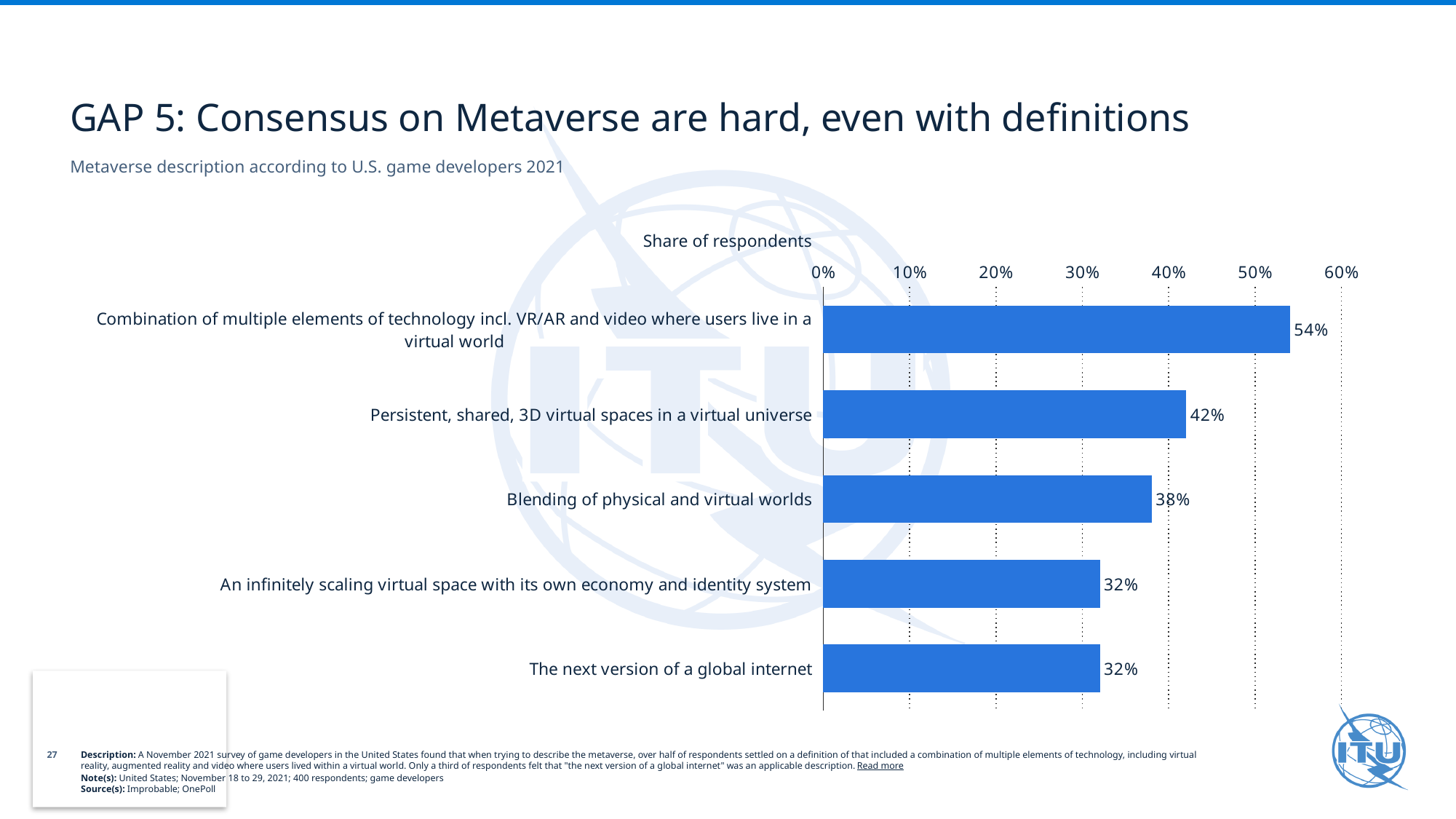
What share of respondents chose "The next version of a global internet"? 32% Is the value for "Blending of physical and virtual worlds" greater or less than 40%? less What is the label of the value axis on the chart? Share of respondents How many metaverse descriptions are shown in the chart? 5 What is the difference in share between the top description (54%) and "Persistent, shared, 3D virtual spaces in a virtual universe"? 12 percentage points What share of respondents described the metaverse as "Persistent, shared, 3D virtual spaces in a virtual universe"? 42% What type of chart is shown on the slide? Bar chart What is the highest tick value shown on the percentage axis? 60% Which has a larger share: "Blending of physical and virtual worlds" or "An infinitely scaling virtual space with its own economy and identity system"? Blending of physical and virtual worlds What is the difference in share between "Blending of physical and virtual worlds" and "The next version of a global internet"? 6 percentage points Which description received the highest share of respondents? Combination of multiple elements of technology incl. VR/AR and video where users live in a virtual world What share of respondents chose "Blending of physical and virtual worlds"? 38%